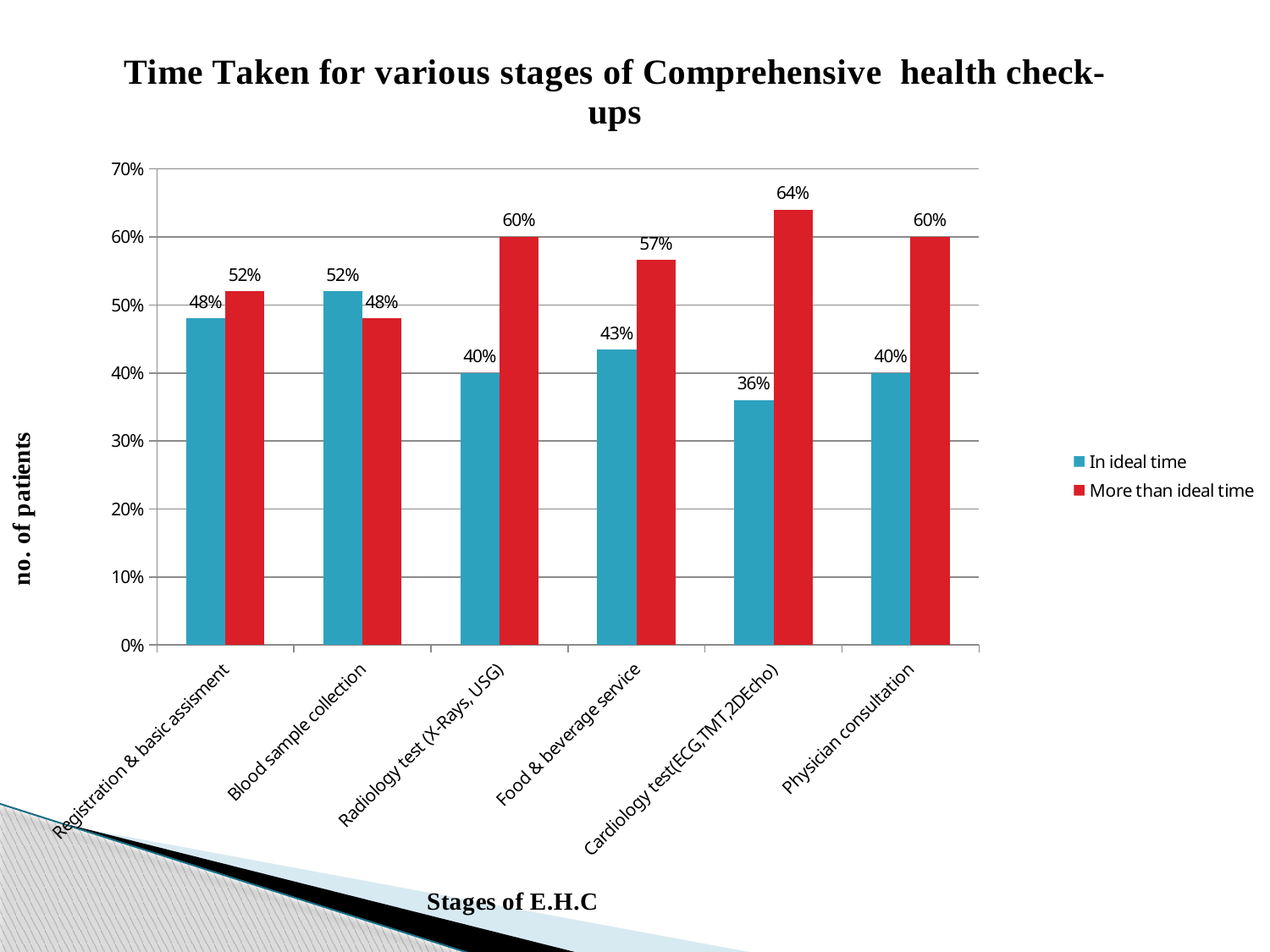
What is the value for 'In ideal time' for Food & beverage service? 43% What is the difference between 'More than ideal time' and 'In ideal time' for Cardiology test(ECG,TMT,2DEcho)? 28% How many series does the legend list? 2 For Blood sample collection, which is larger: 'In ideal time' or 'More than ideal time'? In ideal time What is the label of the x axis? Stages of E.H.C Which stage has the lowest 'In ideal time' value? Cardiology test(ECG,TMT,2DEcho) How many stages are shown on the x axis? 6 What kind of chart is shown on the slide? Bar chart Which stage has the highest 'More than ideal time' value? Cardiology test(ECG,TMT,2DEcho) Is the 'More than ideal time' value for Food & beverage service greater or less than 50%? greater What is the value for 'In ideal time' for Blood sample collection? 52% What is the value for 'More than ideal time' for Cardiology test(ECG,TMT,2DEcho)? 64%